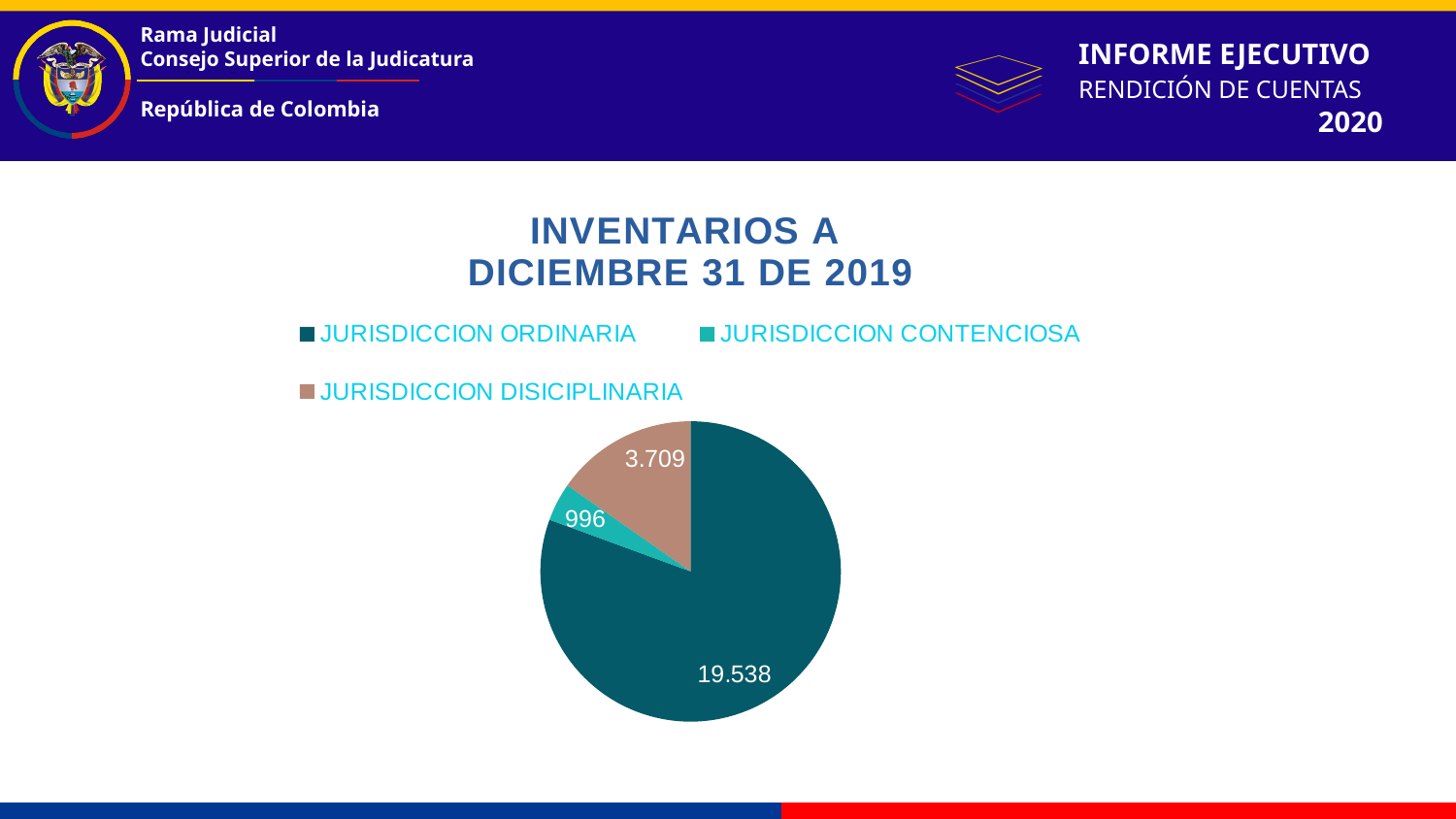
What is the difference between the values for JURISDICCION ORDINARIA and JURISDICCION DISICIPLINARIA? 15.829 How many slices does the pie chart have? 3 What is the value for JURISDICCION ORDINARIA? 19.538 How many entries does the legend list? 3 What is the total of all three slices in the pie chart? 24.243 What is the value for JURISDICCION CONTENCIOSA? 996 What is the value for JURISDICCION DISICIPLINARIA? 3.709 What type of chart is shown on the slide? Pie chart What is the title of the chart? INVENTARIOS A DICIEMBRE 31 DE 2019 Which is larger, the value for JURISDICCION DISICIPLINARIA or JURISDICCION CONTENCIOSA? JURISDICCION DISICIPLINARIA Which jurisdiction has the smallest slice of the pie? JURISDICCION CONTENCIOSA Which jurisdiction has the largest slice of the pie? JURISDICCION ORDINARIA